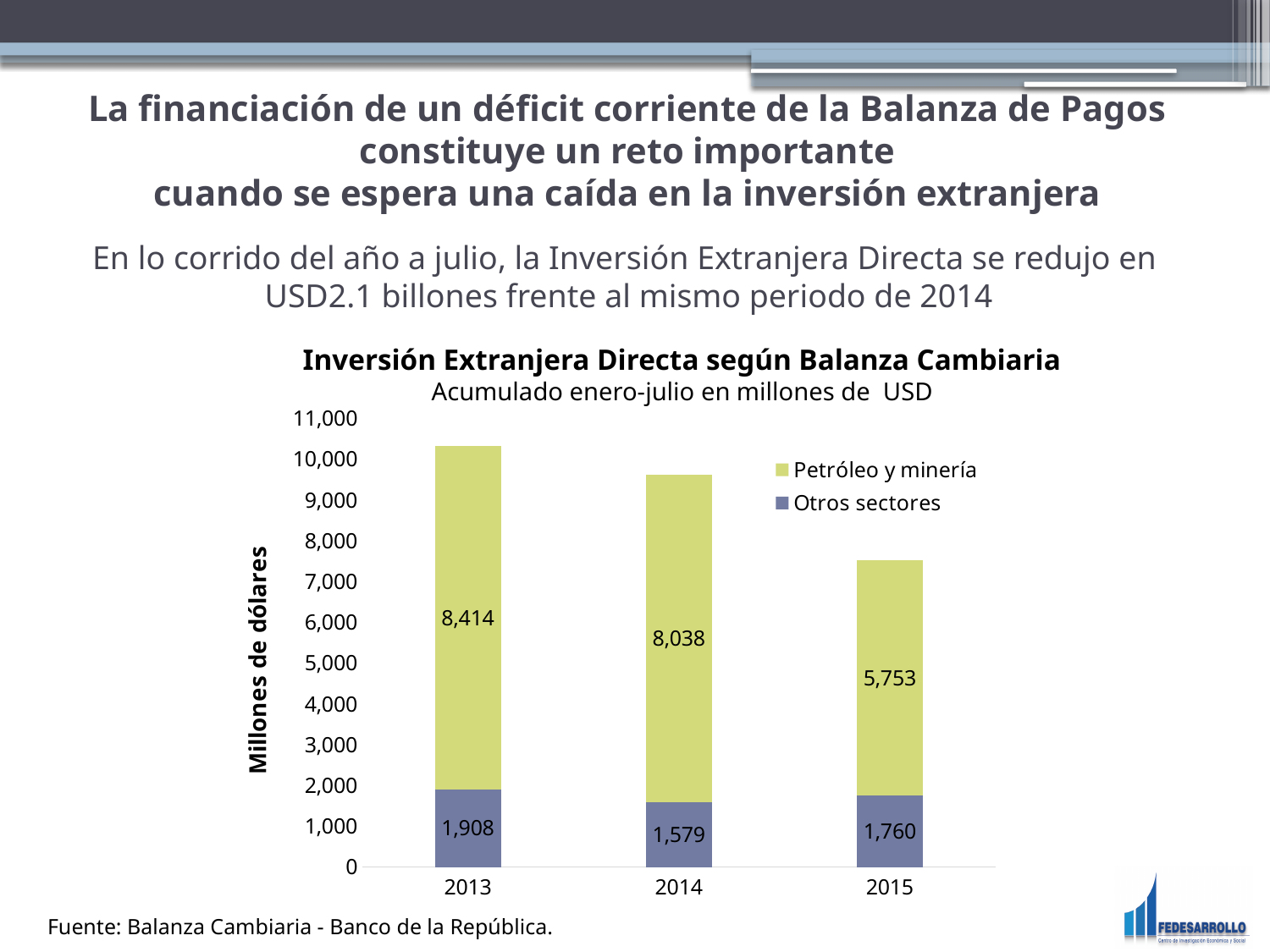
How many years are shown on the x axis? 3 What kind of chart is shown on the slide? Stacked bar chart What is the value for Petróleo y minería in 2015? 5,753 How many series does the legend list? 2 What is the value for Otros sectores in 2014? 1,579 In which year is the Otros sectores value the highest? 2013 Which is larger, the Otros sectores value for 2015 or for 2014? 2015 What is the total of the stacked bar for 2015? 7,513 What is the value for Petróleo y minería in 2013? 8,414 What is the difference between the Petróleo y minería values for 2014 and 2015? 2,285 In which year is the Petróleo y minería value the lowest? 2015 What is the total of the stacked bar for 2013? 10,322